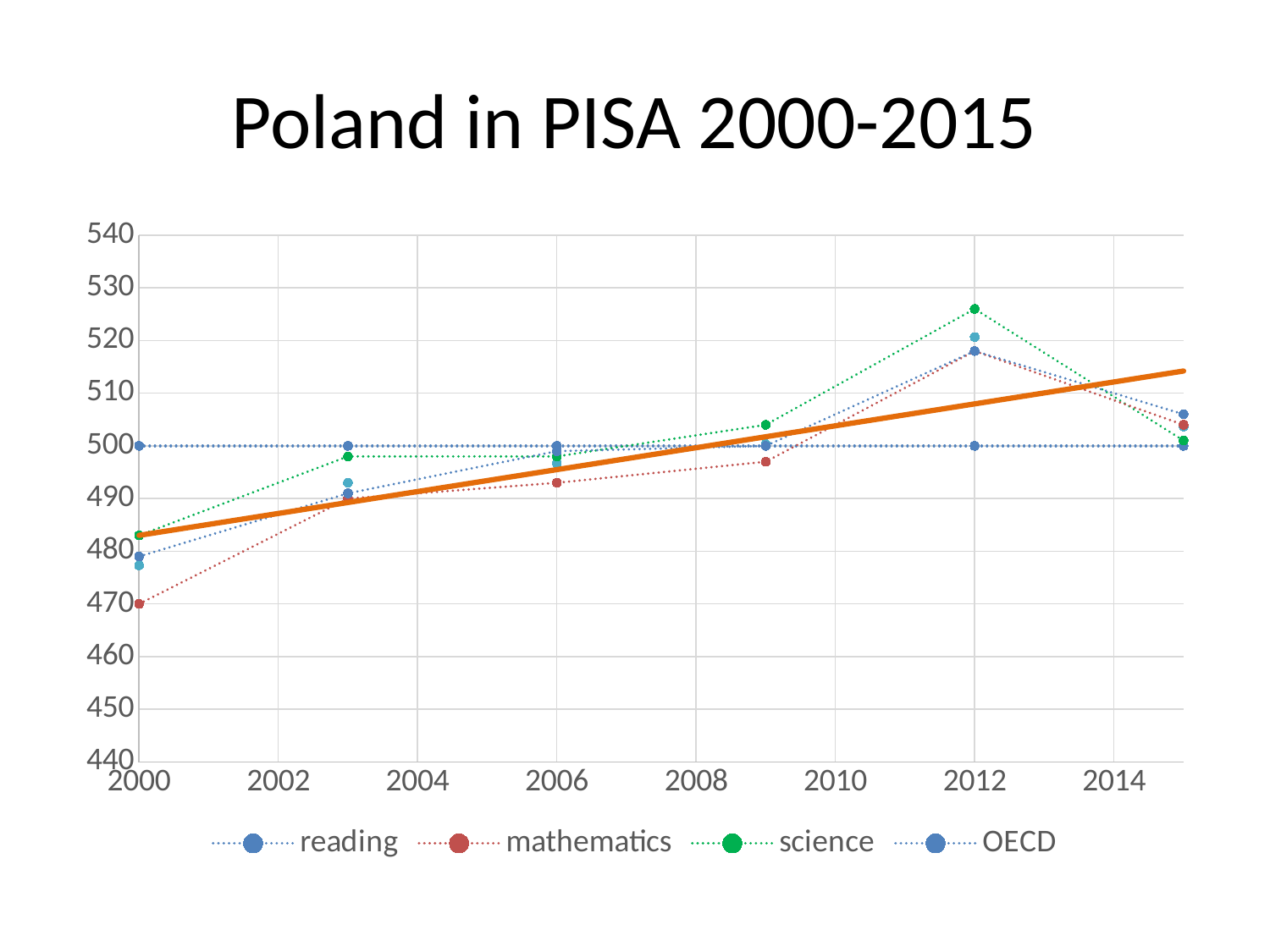
Which series are listed in the legend? reading, mathematics, science, OECD Is the value for mathematics in 2006 greater or less than 500? less Which series has the lowest value in 2000? mathematics Which series reaches the highest value in 2012? science What kind of chart is shown on the slide? line chart Does the science series rise or fall between 2012 and 2015? fall What is the title of the chart? Poland in PISA 2000-2015 Is the value for mathematics in 2000 greater or less than 480? less How many years are plotted for each series? 6 How many series does the legend list? 4 What is the value of the OECD series across all years? 500 Is the value for science in 2012 greater or less than 520? greater